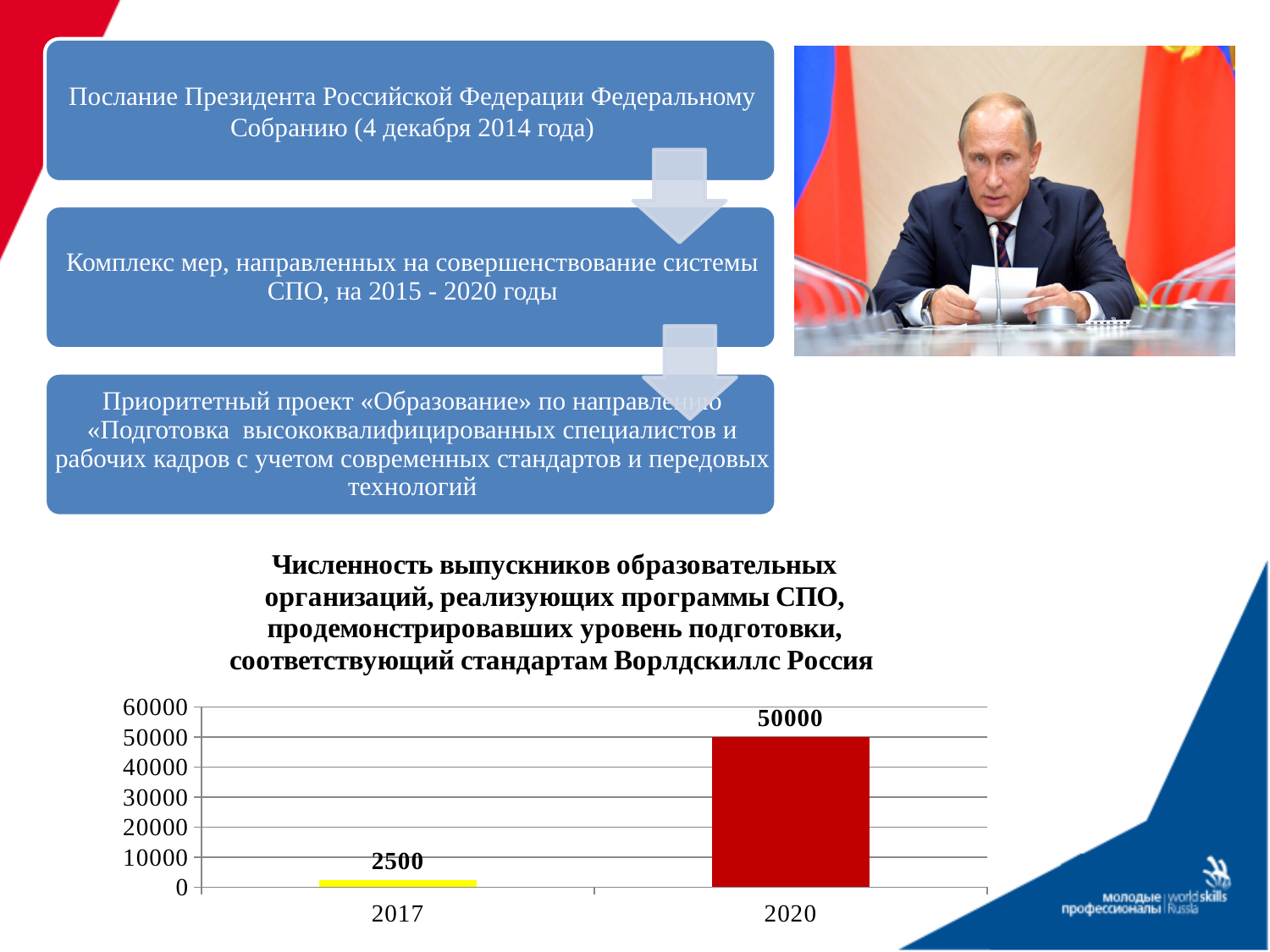
How many categories are shown on the x axis of the chart? 2 Which year has the higher value? 2020 Is the value for 2020 greater or less than 40000? greater What is the difference between the values for 2020 and 2017? 47500 What colour is the bar for 2020? Red Is the value for 2020 larger than the value for 2017? Yes What is the value shown for 2020? 50000 Is the value for 2017 greater or less than 10000? less What kind of chart is shown on the slide? Bar chart Do the values rise or fall from 2017 to 2020? Rise What is the value shown for 2017? 2500 Which year has the lower value? 2017